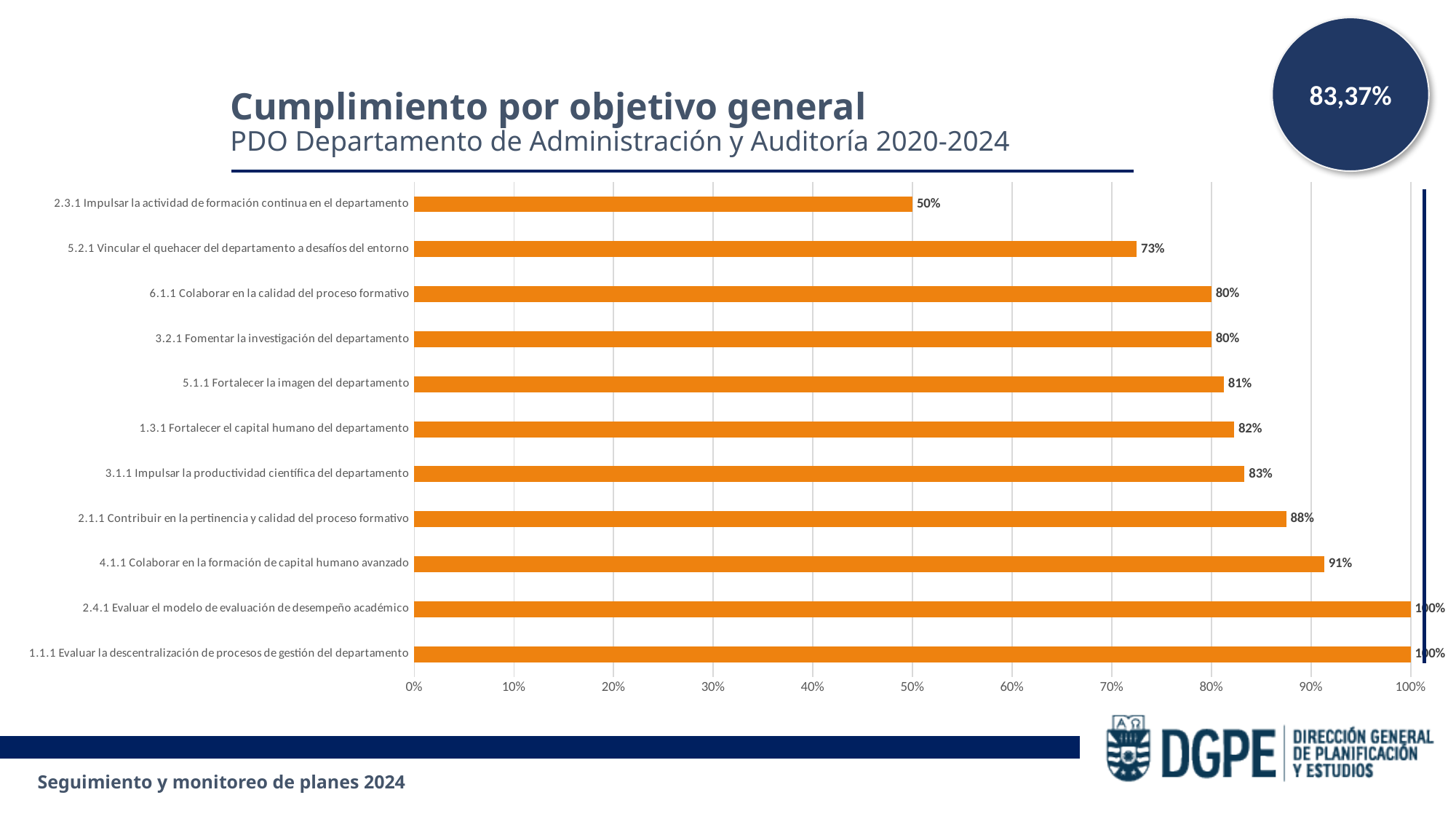
What kind of chart is shown on the slide? bar chart Which category has the lowest value? 2.3.1 Impulsar la actividad de formación continua en el departamento What is the value for 4.1.1 Colaborar en la formación de capital humano avanzado? 91% Is the value for 5.1.1 Fortalecer la imagen del departamento greater or less than 70%? greater What is the value for 2.1.1 Contribuir en la pertinencia y calidad del proceso formativo? 88% What is the title of the chart? Cumplimiento por objetivo general What is the value for 5.2.1 Vincular el quehacer del departamento a desafíos del entorno? 73% How many categories have a value of 100%? 2 How many categories are shown in the chart? 11 Which is larger, the value for 3.1.1 Impulsar la productividad científica del departamento or the value for 5.2.1 Vincular el quehacer del departamento a desafíos del entorno? 3.1.1 Impulsar la productividad científica del departamento What is the difference between the values for 4.1.1 Colaborar en la formación de capital humano avanzado and 2.3.1 Impulsar la actividad de formación continua en el departamento? 41% What is the value for 2.3.1 Impulsar la actividad de formación continua en el departamento? 50%